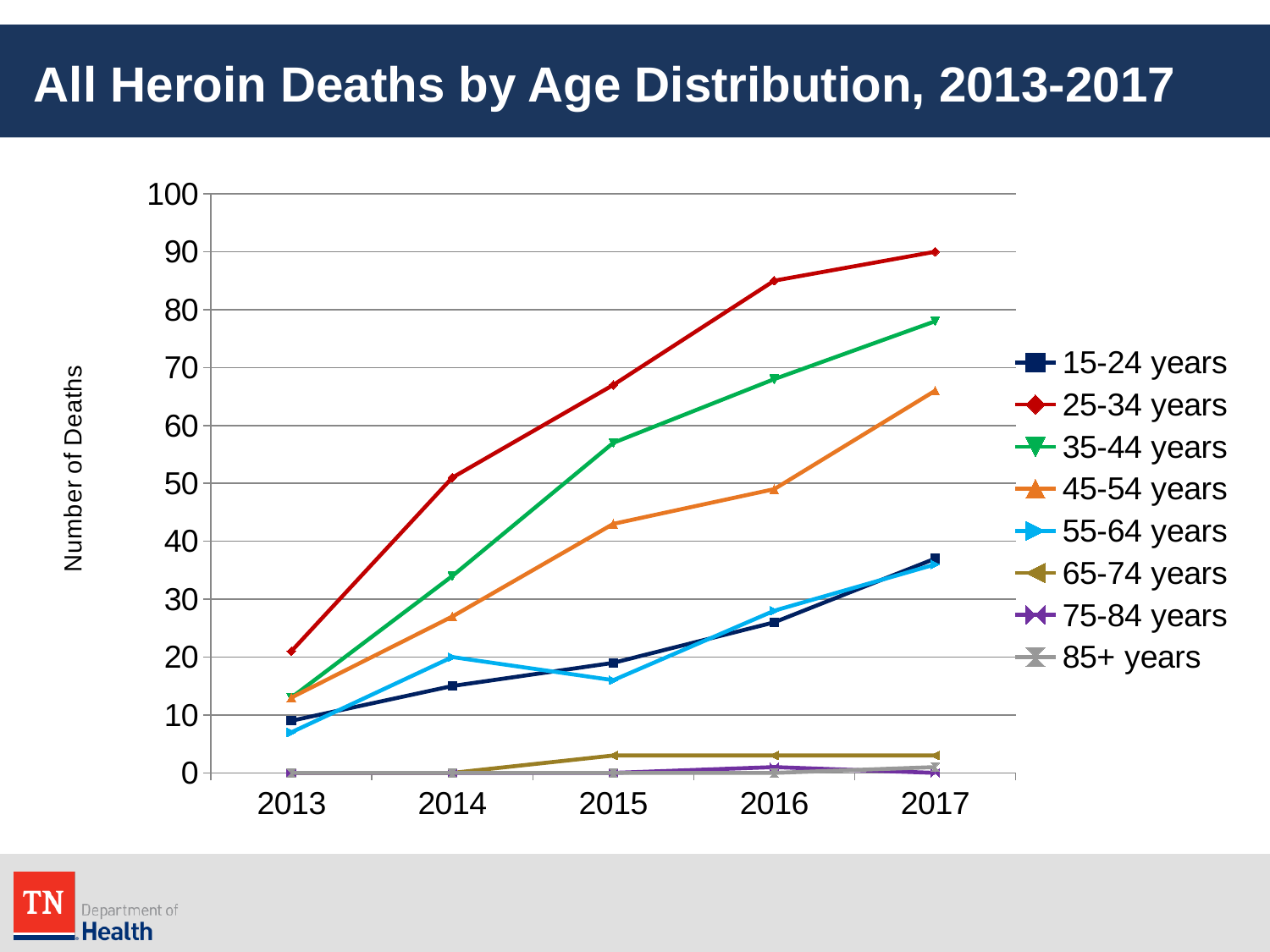
Is the value for 35-44 years in 2015 greater or less than 50? greater Is the value for 25-34 years in 2016 greater or less than 80? greater Does the number of deaths for 25-34 years rise or fall from 2013 to 2017? rise What kind of chart is shown on the slide? line chart Which is larger in 2016, the value for 35-44 years or the value for 45-54 years? 35-44 years Is the value for 45-54 years in 2014 greater or less than 30? less What is the label of the y axis? Number of Deaths How many series does the legend list? 8 Which age group has the highest number of deaths in 2013? 25-34 years How many years are shown on the x axis? 5 Which age group has the highest number of deaths in 2017? 25-34 years